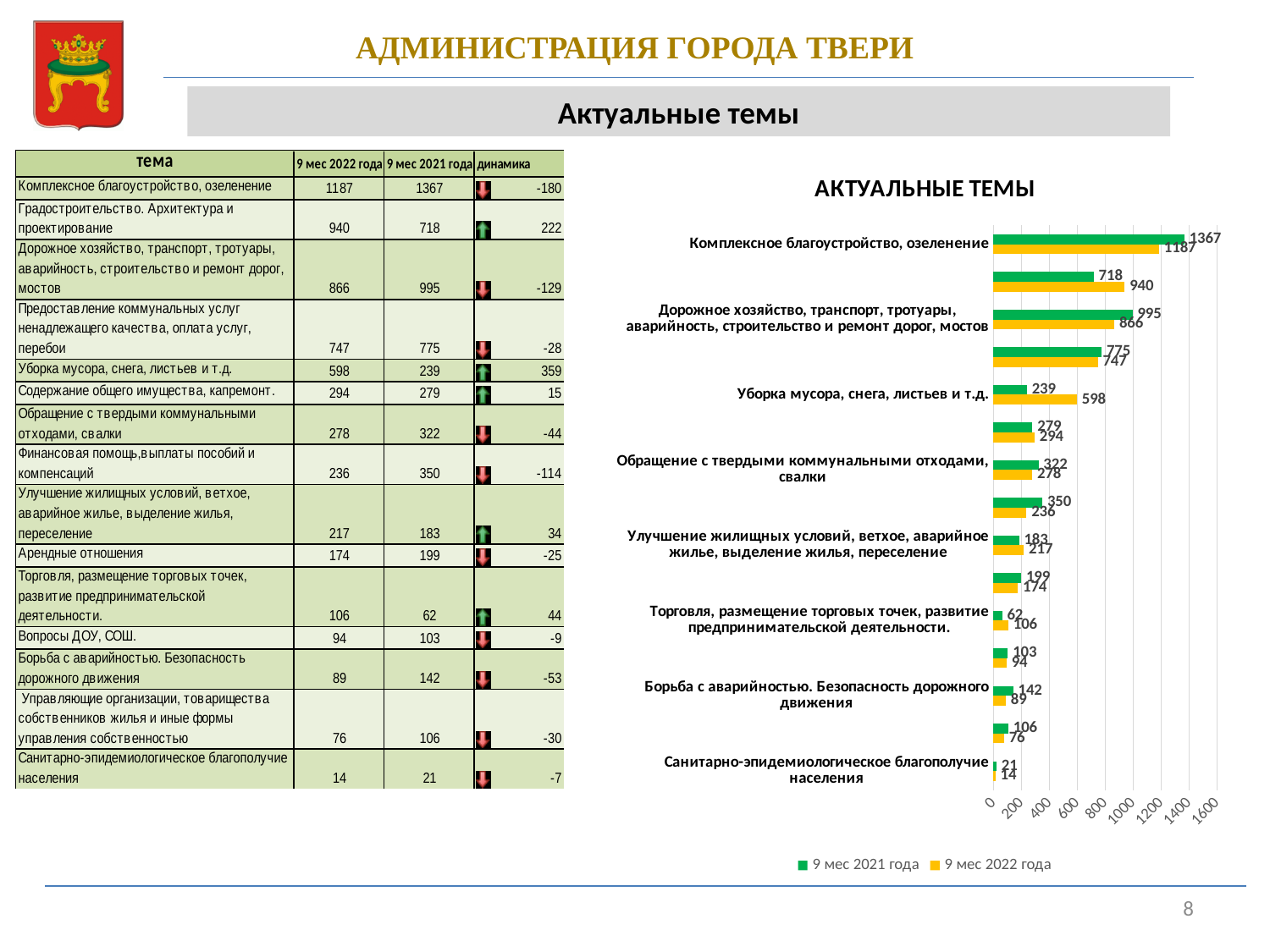
Which category has the lowest value in the 9 мес 2022 года series? Санитарно-эпидемиологическое благополучие населения What is the difference between the 9 мес 2021 года and 9 мес 2022 года values for Комплексное благоустройство, озеленение? 180 What is the title of the chart? АКТУАЛЬНЫЕ ТЕМЫ How many series does the chart legend list? 2 What kind of chart is shown on the slide? bar chart What is the value for Торговля, размещение торговых точек, развитие предпринимательской деятельности in the 9 мес 2021 года series? 62 Is the 9 мес 2022 года value for Обращение с твердыми коммунальными отходами, свалки greater or less than 400? less What is the value for Комплексное благоустройство, озеленение in the 9 мес 2022 года series? 1187 What is the value for Уборка мусора, снега, листьев и т.д. in the 9 мес 2021 года series? 239 By how much does the 9 мес 2022 года value exceed the 9 мес 2021 года value for Уборка мусора, снега, листьев и т.д.? 359 Which category has the highest value in the 9 мес 2022 года series? Комплексное благоустройство, озеленение For Дорожное хозяйство, транспорт, тротуары, аварийность, строительство и ремонт дорог, мостов, which series has the larger value? 9 мес 2021 года